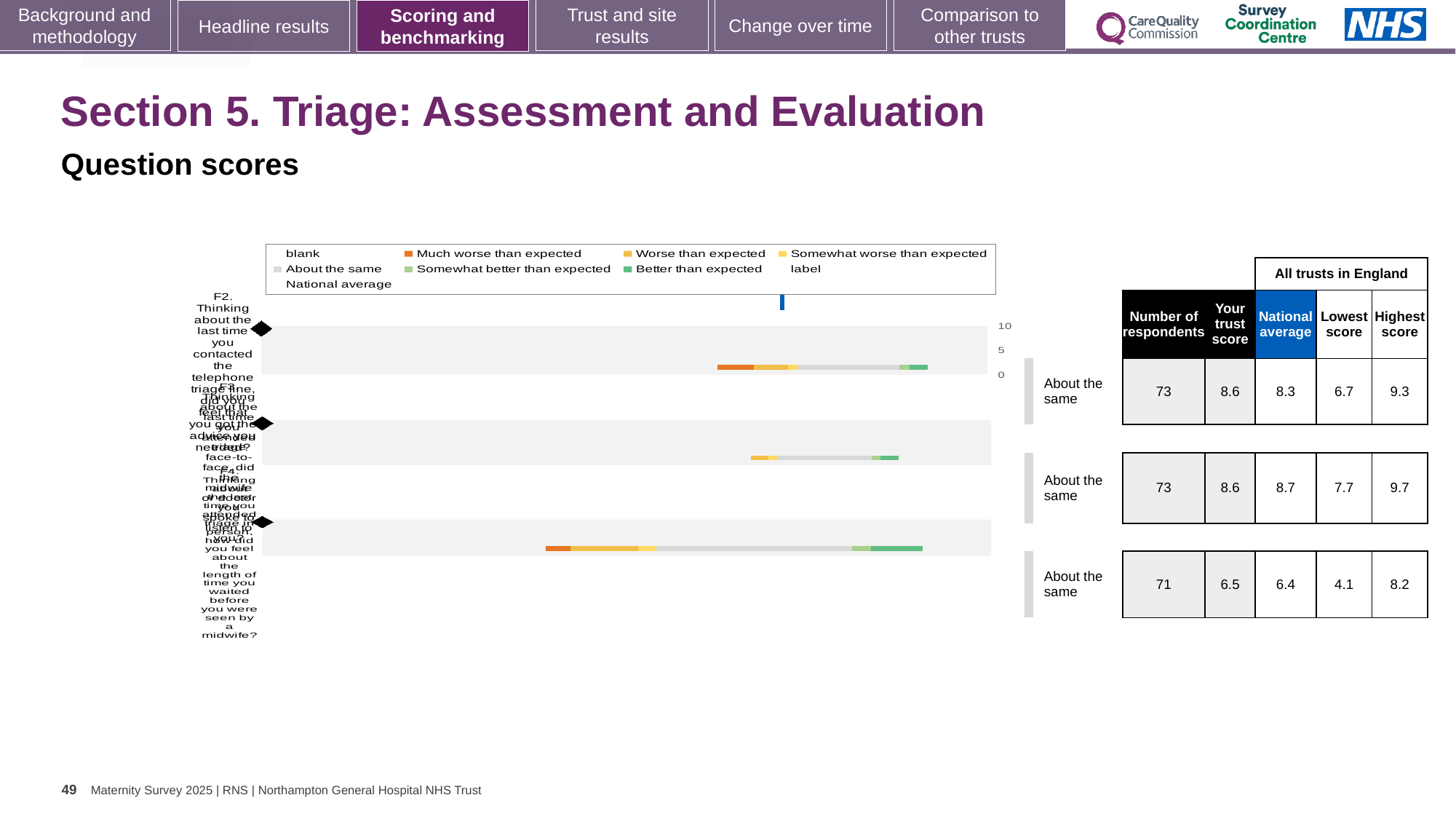
In the table beside the chart, how many respondents are listed for the third row (F4)? 71 In the table beside the chart, what is 'Your trust score' for the first row (F2)? 8.6 In the table beside the chart, for the second row (F3), which is larger: your trust score or the national average? National average In the chart legend, what colour represents 'Much worse than expected'? orange In the table beside the chart, which row has the lowest 'Your trust score'? the third row (F4), 6.5 In the chart legend, what colour represents 'Better than expected'? green What kind of chart is shown on the slide? bar chart In the table beside the chart, which row has the highest 'Highest score' value? the second row (F3), 9.7 In the table beside the chart, what is the national average for the third row (F4)? 6.4 How many questions (bars) are plotted in the chart? 3 What benchmark category is shown for all three questions in the chart? About the same In the table beside the chart, what is the difference between the highest score and the lowest score for the third row (F4)? 4.1